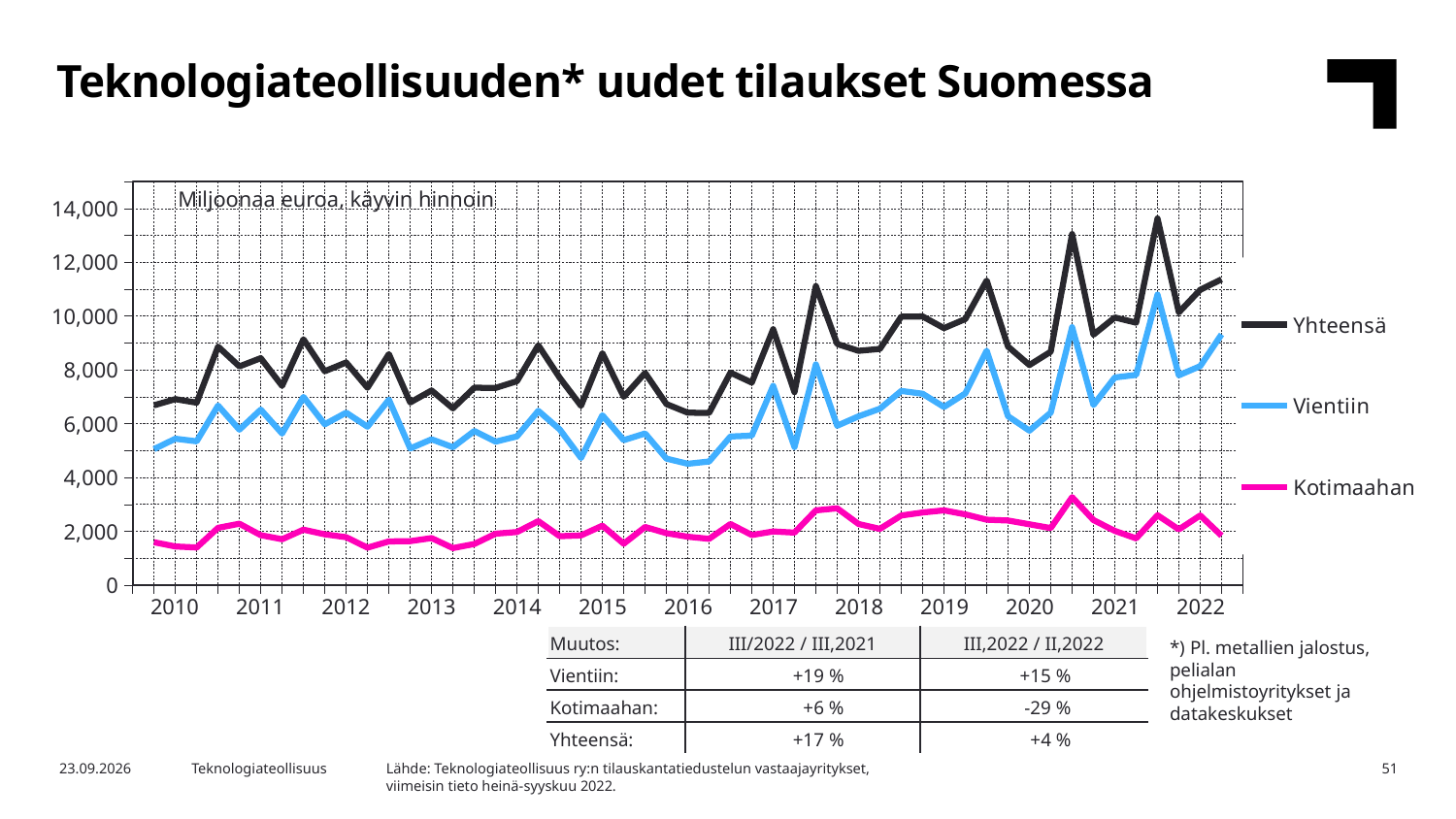
In 2022, which series is larger, Vientiin or Kotimaahan? Vientiin Which series has the highest values throughout the chart? Yhteensä Does the Yhteensä series overall rise or fall from 2010 to 2022? rise Is the value for Kotimaahan in 2010 greater or less than 4,000? less What kind of chart is shown on the slide? Line chart What is the title of the chart on the slide? Teknologiateollisuuden* uudet tilaukset Suomessa Which series has the lowest values throughout the chart? Kotimaahan Is the lowest value for Vientiin in 2016 greater or less than 6,000? less How many years are labelled on the x axis? 13 Is the peak value for Yhteensä in 2021 greater or less than 12,000? greater How many series does the legend list? 3 What are the three series named in the legend? Yhteensä, Vientiin, Kotimaahan